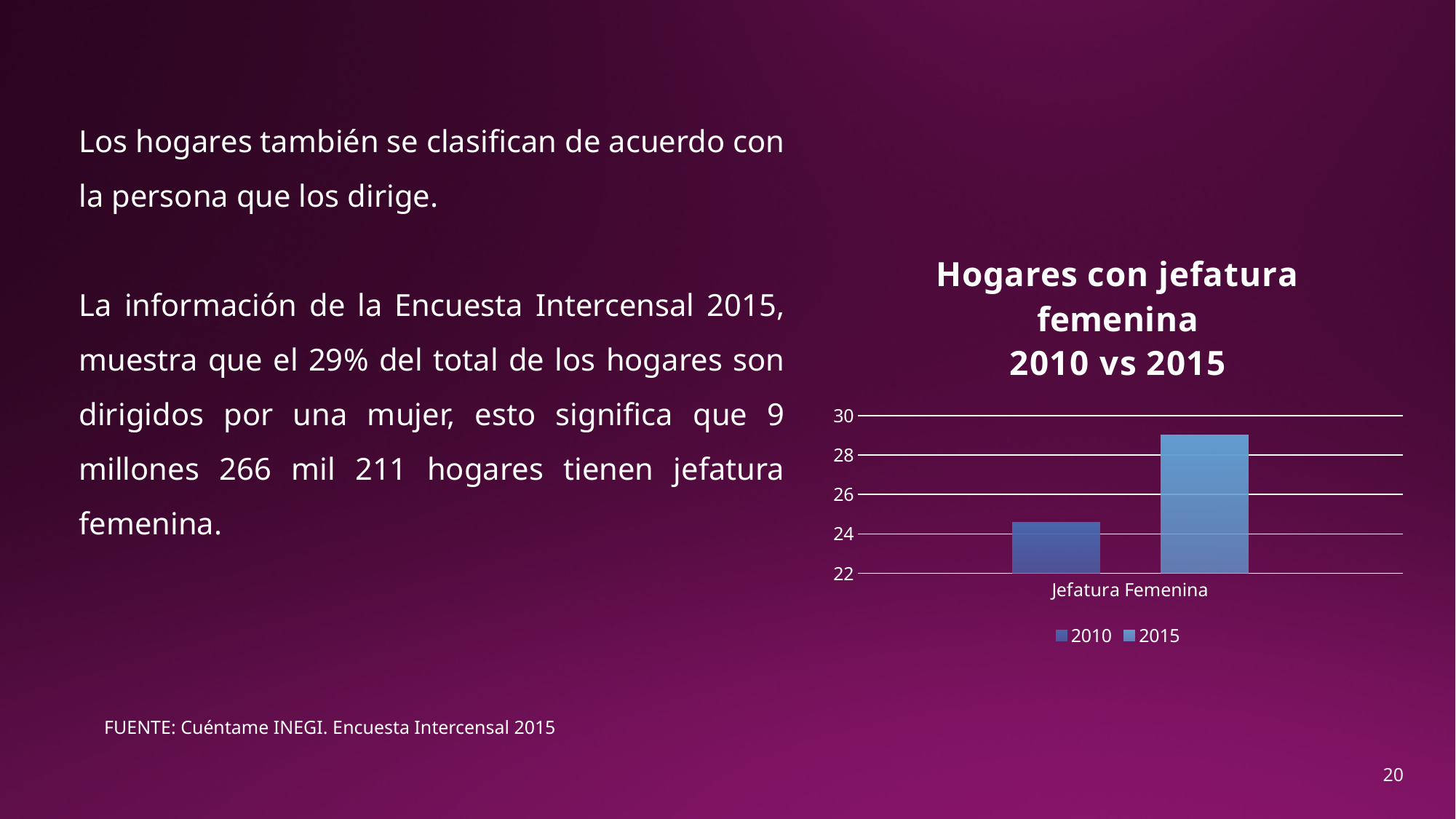
Which series has the highest bar in the chart? 2015 How many series does the chart legend list? 2 What is the title of the chart? Hogares con jefatura femenina 2010 vs 2015 What is the category label on the x axis of the chart? Jefatura Femenina Is the value for 2015 greater or less than 28? greater Which series has the higher bar for Jefatura Femenina, 2010 or 2015? 2015 Is the value for 2010 greater or less than 24? greater How many categories are shown on the x axis of the chart? 1 What kind of chart is shown on the slide? bar chart Is the value for 2010 greater or less than 26? less Which series has the lowest bar in the chart? 2010 Which series are listed in the chart legend? 2010 and 2015